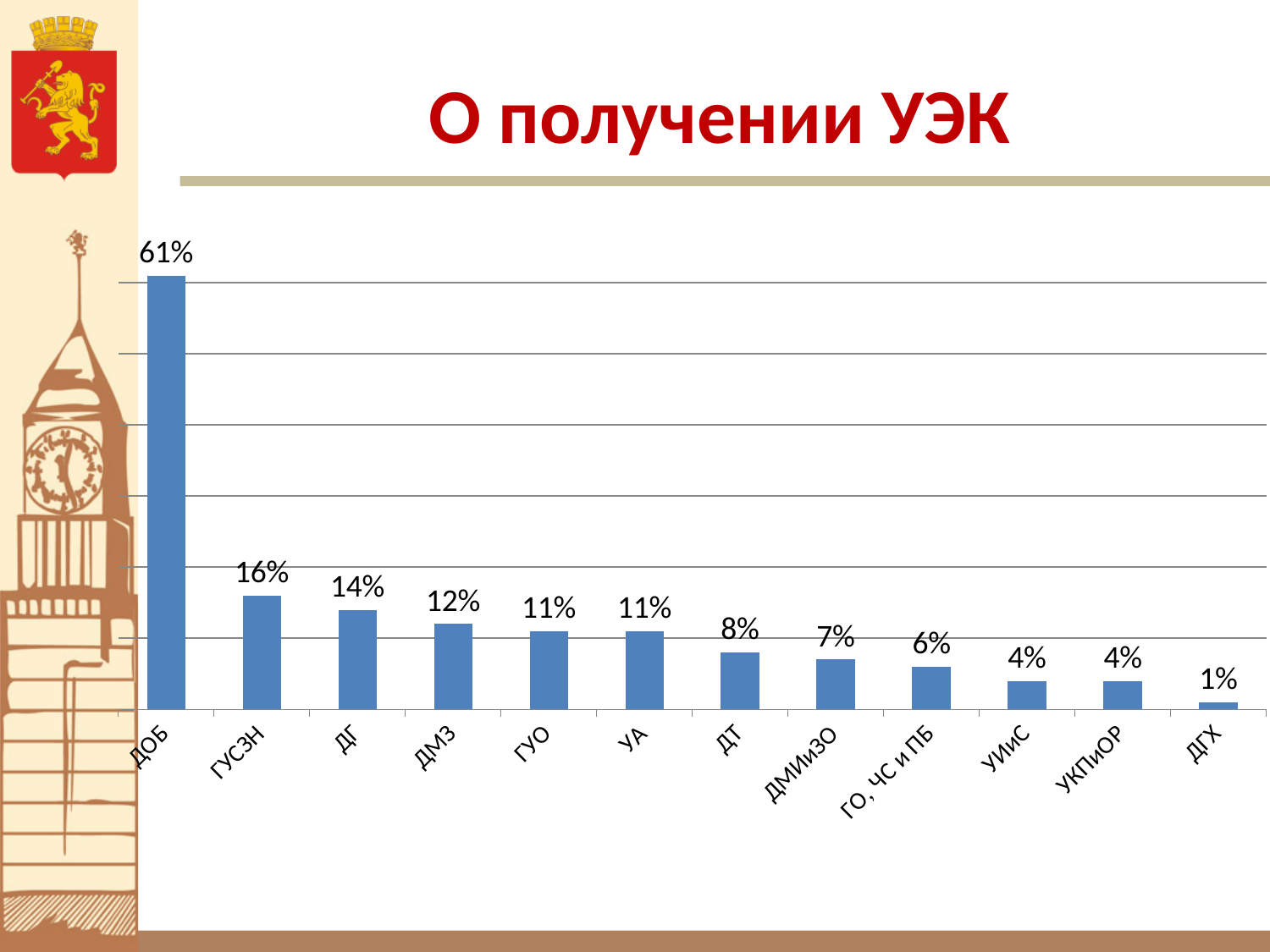
What type of chart is shown on the slide? bar chart What is the value for ДМЗ? 12% What is the value for ГУСЗН? 16% How many categories are shown on the x axis? 12 What is the difference between the values for ДОБ and ГУСЗН? 45% Which category has the highest value? ДОБ What is the value for ДОБ? 61% What is the value for ГО, ЧС и ПБ? 6% What is the title of the slide containing the chart? О получении УЭК Which category has the lowest value? ДГХ What is the difference between the values for ДГ and ДТ? 6% Which is larger, the value for ДМИиЗО or the value for УИиС? ДМИиЗО